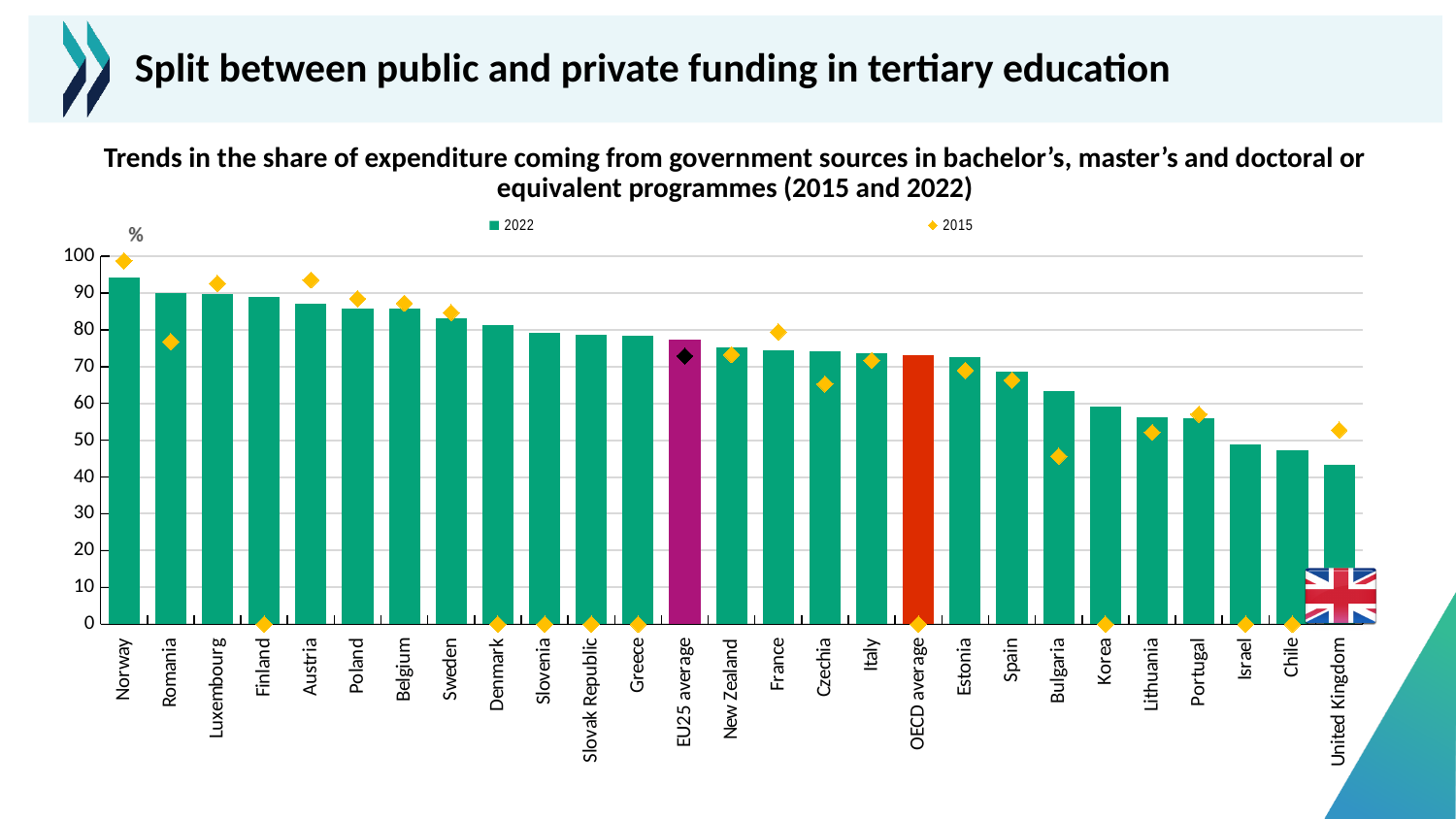
Is the 2022 value for the United Kingdom greater or less than 50? less How many series does the legend list? 2 Is the 2015 value for Bulgaria greater or less than 50? less How many countries or averages are shown along the x axis? 27 Is the 2022 value for Bulgaria greater or less than 60? greater Which country has the lowest 2022 share of expenditure from government sources? United Kingdom What kind of chart is shown on the slide? bar chart Which has the larger 2022 value, Spain or Bulgaria? Spain What colour is the bar for the OECD average? red Do the 2022 bars rise or fall from left to right along the x axis? fall Which country has the highest 2022 share of expenditure from government sources? Norway